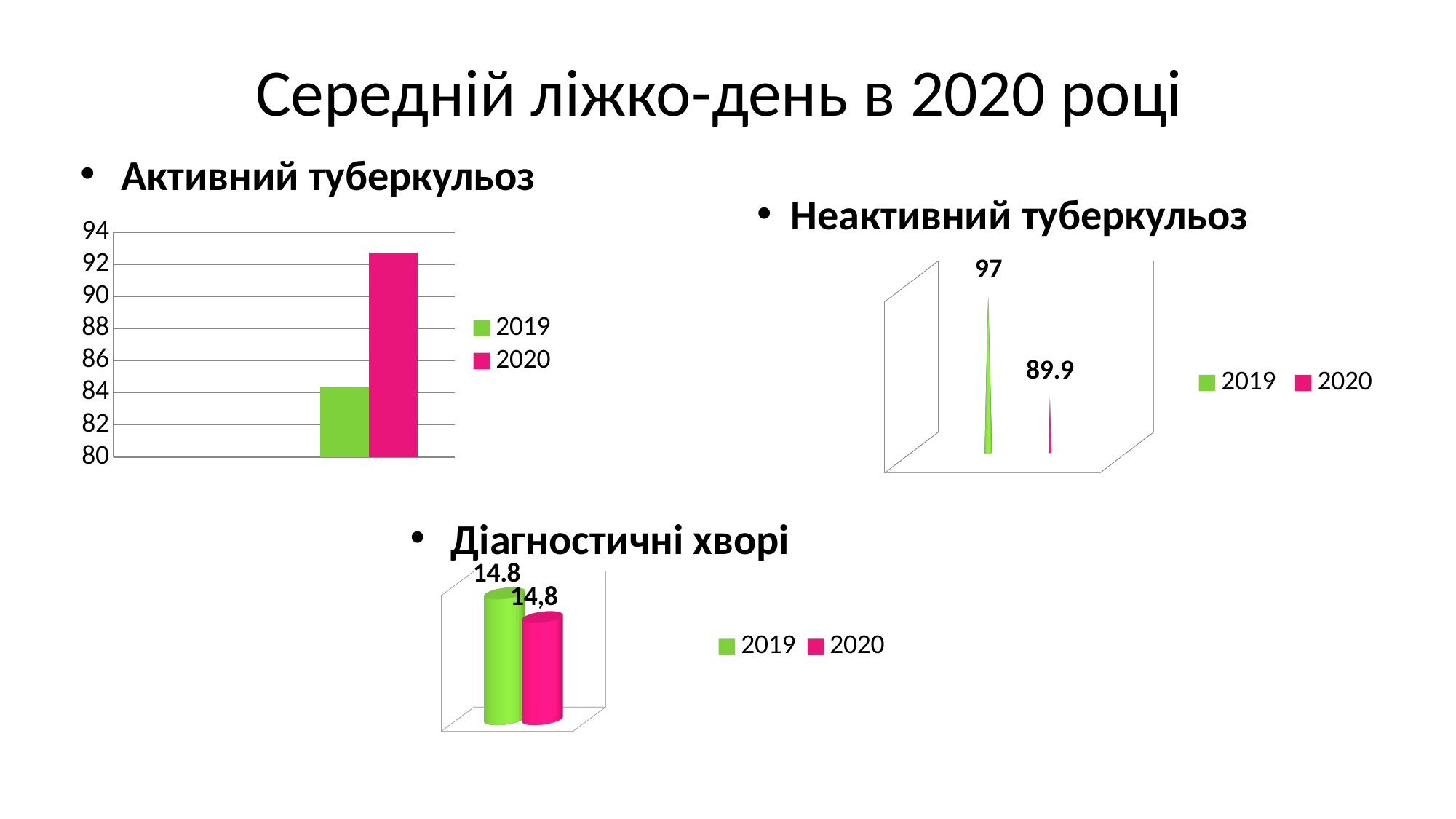
In the 'Діагностичні хворі' chart, which colour represents 2020? Pink In the 'Неактивний туберкульоз' chart, what is the difference between the 2019 and 2020 values? 7.1 In the 'Неактивний туберкульоз' chart, what is the value for 2020? 89.9 In the 'Неактивний туберкульоз' chart, what is the value for 2019? 97 In the 'Активний туберкульоз' chart, which year has the higher value? 2020 How many series does the legend of the 'Активний туберкульоз' chart list? 2 In the 'Діагностичні хворі' chart, what is the value for 2020? 14,8 What kind of chart is the 'Активний туберкульоз' chart? Bar chart In the 'Активний туберкульоз' chart, is the value for 2019 greater or less than 86? less In the 'Активний туберкульоз' chart, is the value for 2020 greater or less than 90? greater In the 'Неактивний туберкульоз' chart, which year has the higher value? 2019 In the 'Діагностичні хворі' chart, what is the value for 2019? 14.8